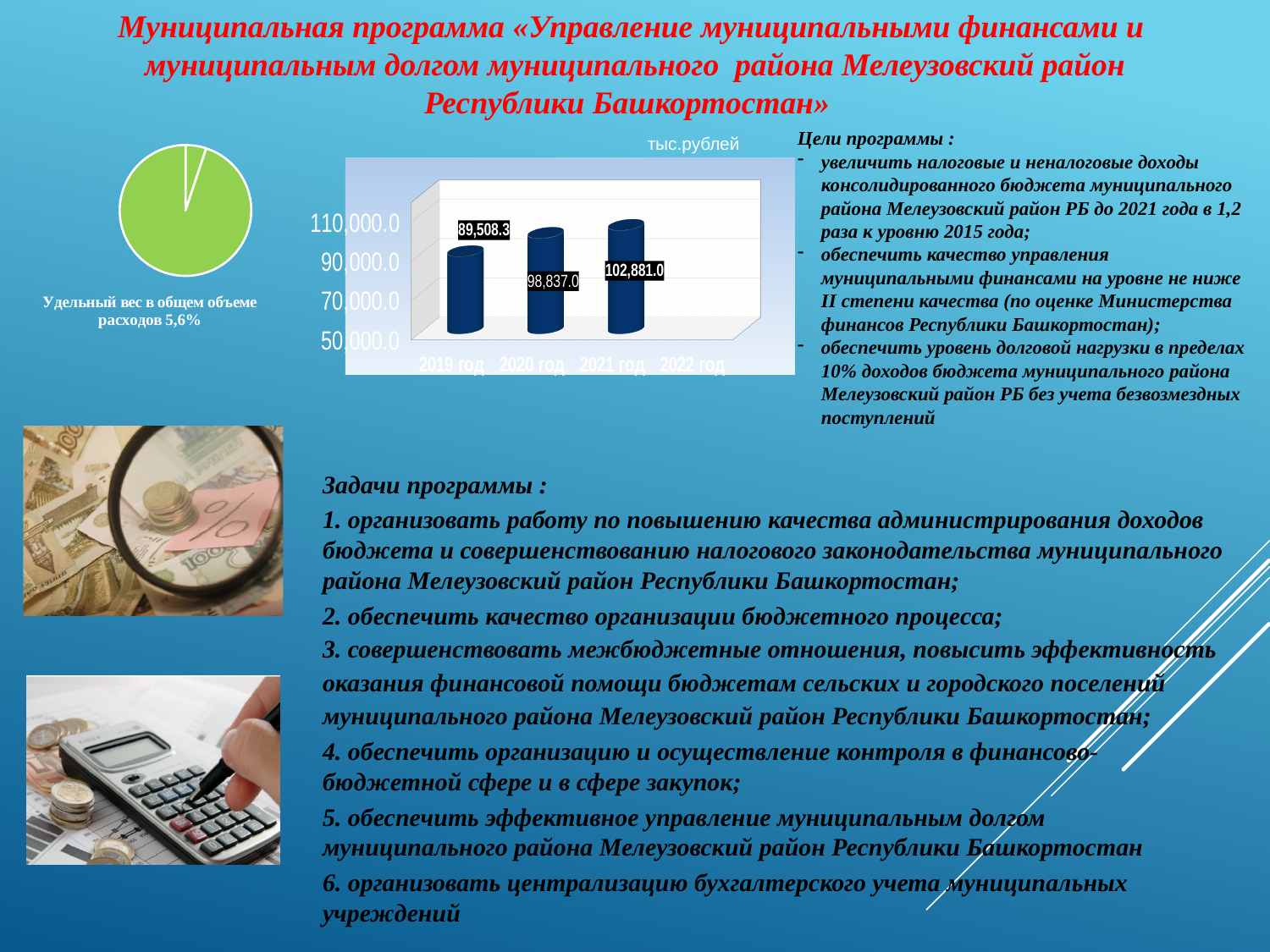
In the bar chart, what is the difference between the values for 2021 год and 2020 год? 4,044.0 In the bar chart, do the values rise or fall from 2019 год to 2021 год? rise In the bar chart, what is the difference between the values for 2021 год and 2019 год? 13,372.7 In the bar chart, which year has the lowest plotted value? 2019 год In the bar chart, what is the value for 2021 год? 102,881.0 In the bar chart, which is larger: the value for 2020 год or the value for 2019 год? 2020 год What type of chart is shown on the left of the slide, above the caption 'Удельный вес в общем объеме расходов 5,6%'? pie chart In the bar chart, what is the value for 2020 год? 98,837.0 In the bar chart, what is the value for 2019 год? 89,508.3 In the bar chart, which year has the highest value? 2021 год How many bars are plotted in the bar chart? 3 What unit is shown above the bar chart? тыс.рублей